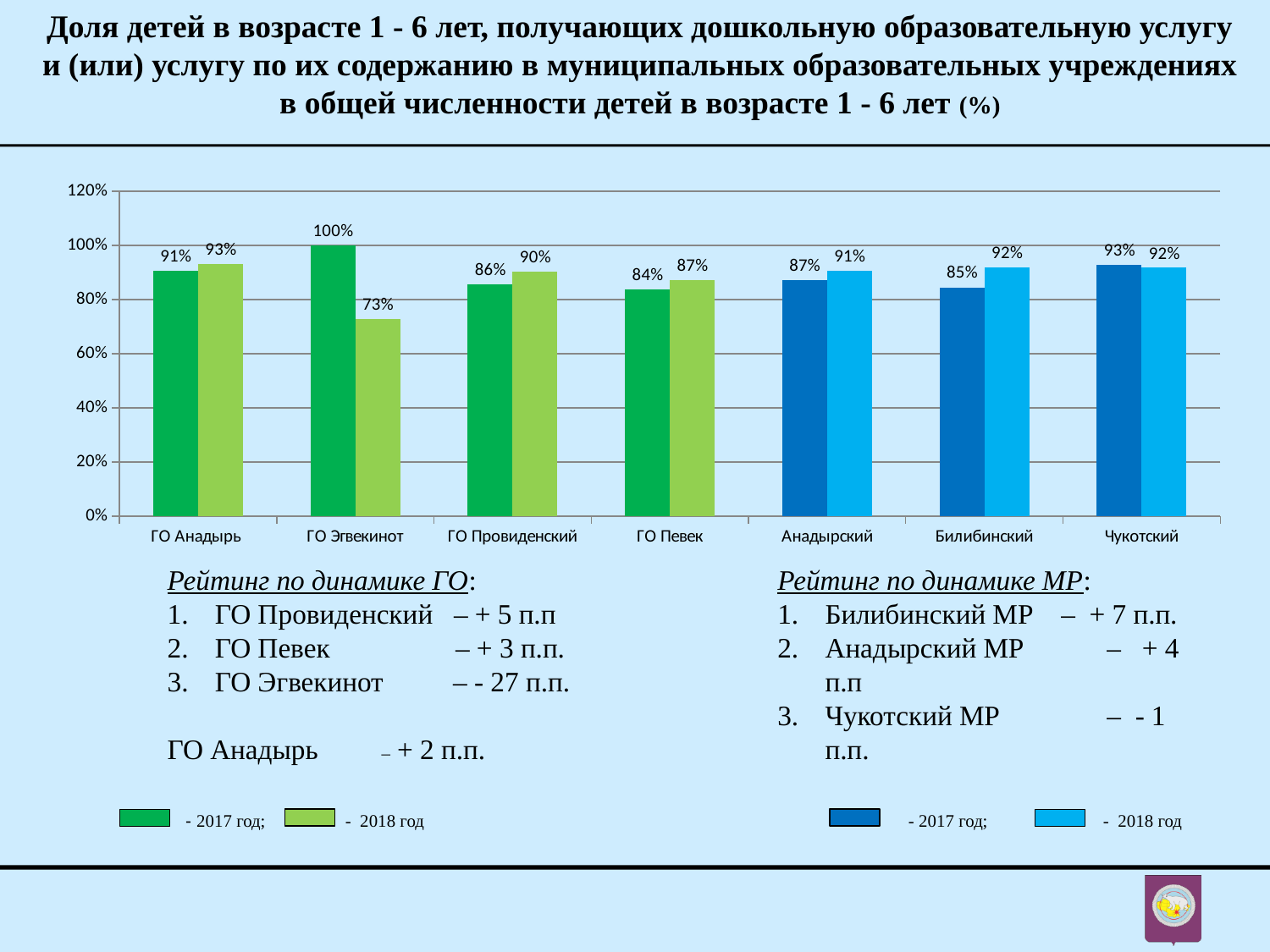
How many categories are shown on the x axis? 7 Which is larger for Чукотский: the 2017 value or the 2018 value? 2017 value What is the 2018 value for ГО Провиденский? 90% Which category has the highest 2017 value? ГО Эгвекинот Which category has the lowest 2018 value? ГО Эгвекинот Is the 2018 value for ГО Эгвекинот greater or less than 80%? less What is the difference between the 2017 and 2018 values for ГО Эгвекинот? 27 percentage points What is the difference between the 2018 and 2017 values for Билибинский? 7 percentage points Which two years does the legend list? 2017 and 2018 What is the 2018 value for ГО Эгвекинот? 73% What type of chart is shown on the slide? bar chart What is the 2017 value for Билибинский? 85%